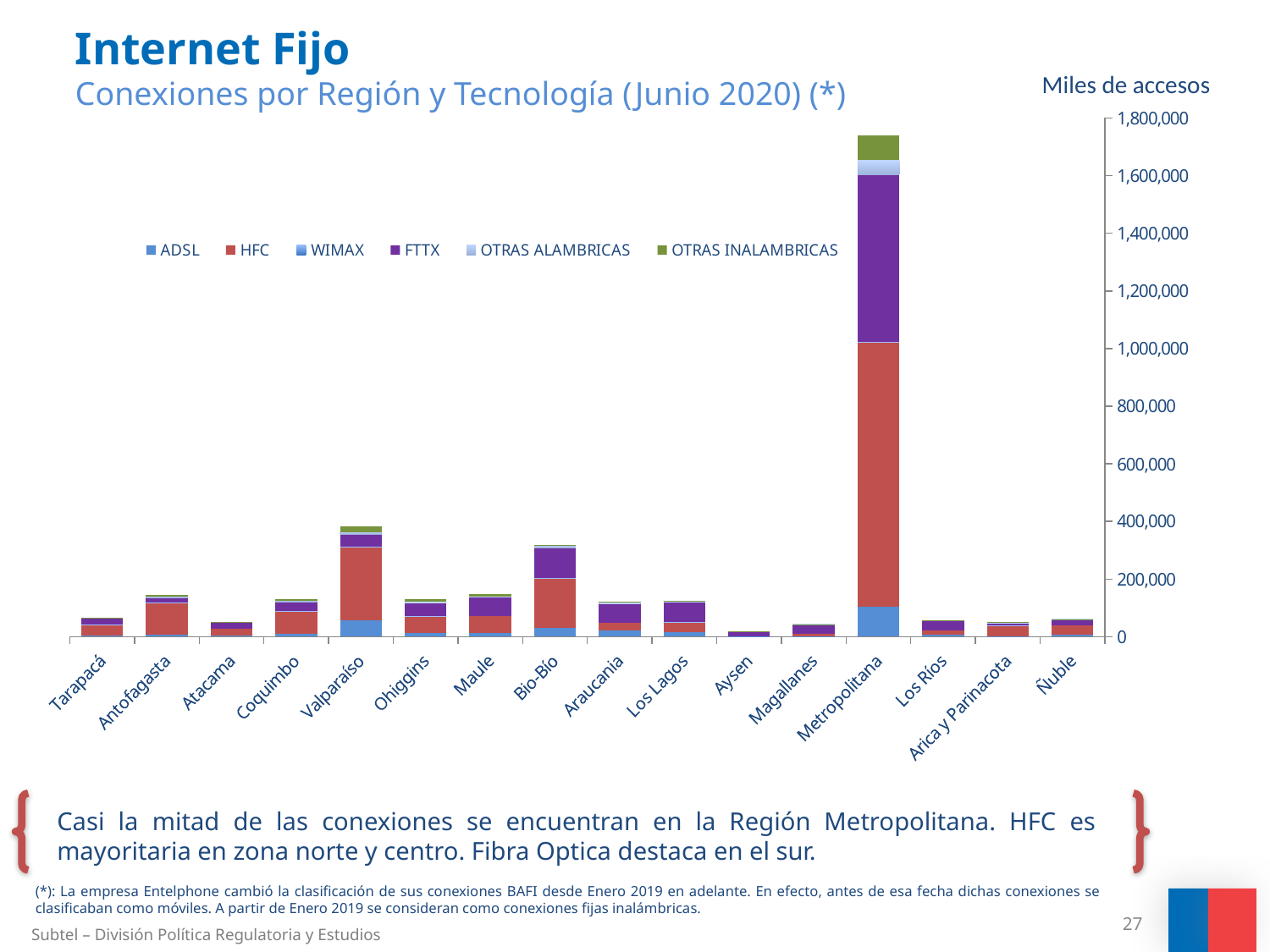
Which technology is listed first in the chart's legend? ADSL Is the total value for Metropolitana greater or less than 1,600,000? greater Which region has a larger total, Valparaíso or Bio-Bío? Valparaíso Which region has the lowest total number of connections? Aysen Is the total value for Valparaíso greater or less than 200,000? greater How many series does the chart's legend list? 6 Which region has a larger total, Antofagasta or Atacama? Antofagasta What unit label is shown above the vertical axis of the chart? Miles de accesos Which region has the highest total number of connections? Metropolitana What kind of chart is shown on the slide? Stacked bar chart How many regions are shown along the x axis of the chart? 16 Is the total value for Tarapacá greater or less than 200,000? less